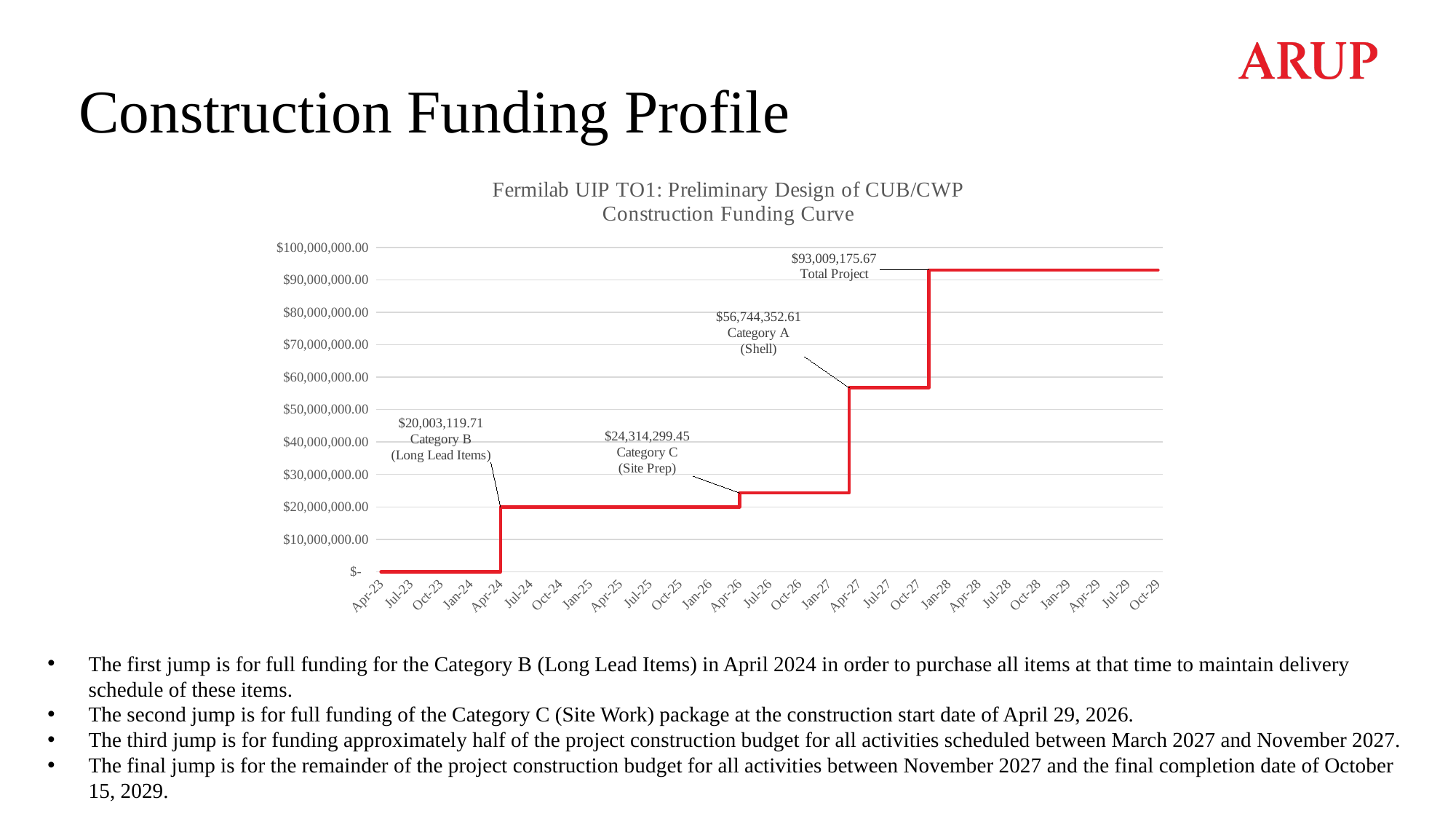
What is the difference between the Total Project value and the Category A (Shell) value? $36,264,823.06 What is the value labelled for Category A (Shell) on the funding curve? $56,744,352.61 What is the value labelled for Category B (Long Lead Items) on the funding curve? $20,003,119.71 What is the value labelled for Category C (Site Prep) on the funding curve? $24,314,299.45 What is the Total Project value labelled on the funding curve? $93,009,175.67 What is the title of the chart? Fermilab UIP TO1: Preliminary Design of CUB/CWP Construction Funding Curve Does the funding curve rise or fall from Apr-23 to Oct-29? Rise Which is larger, the labelled value for Category A (Shell) or for Category C (Site Prep)? Category A (Shell) What kind of chart is used to show the construction funding curve? Line chart Which labelled point on the funding curve has the lowest value? Category B (Long Lead Items) What is the difference between the Category C (Site Prep) value and the Category B (Long Lead Items) value? $4,311,179.74 Is the value of the funding curve at Jan-25 greater or less than $30,000,000.00? less